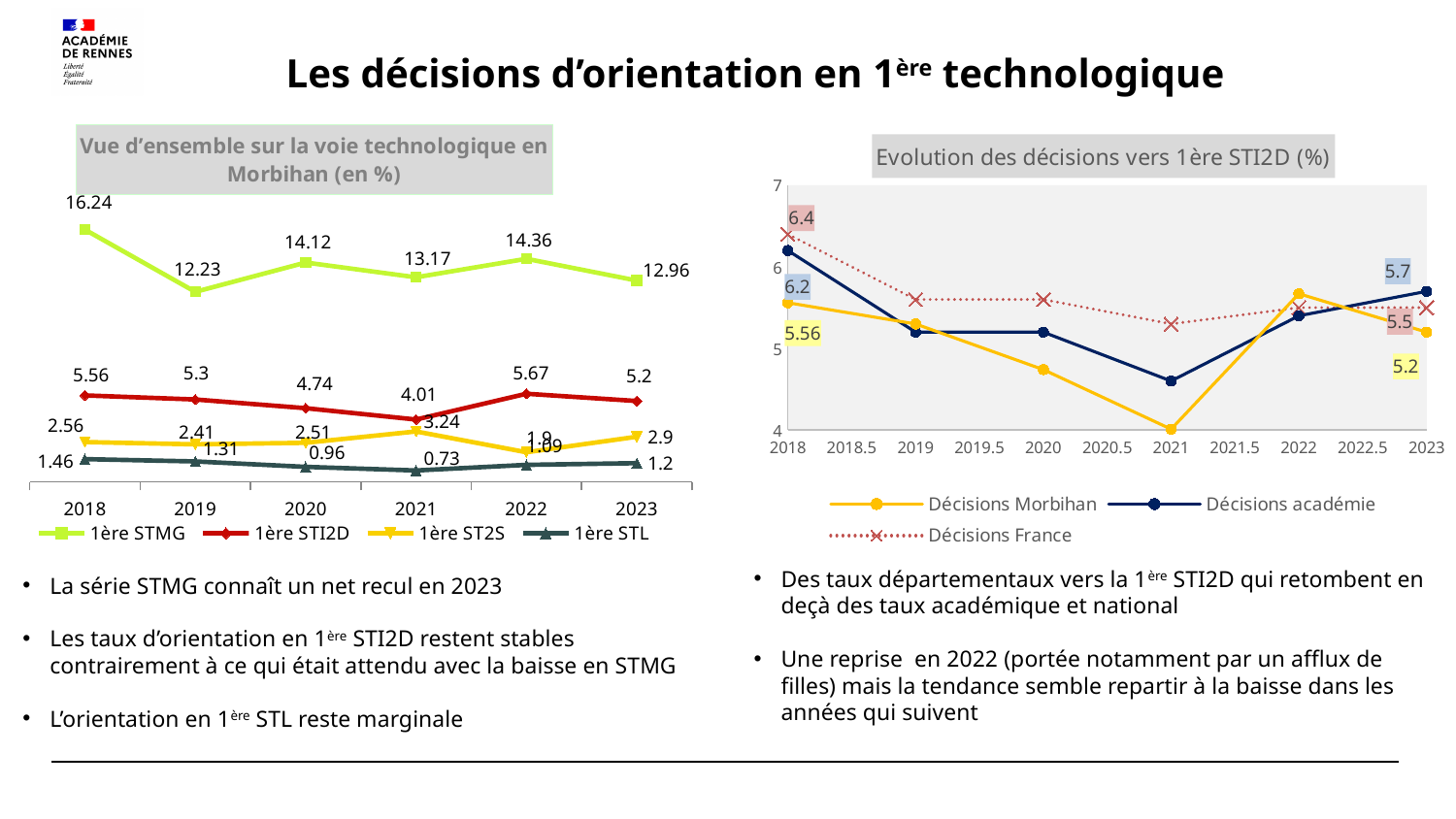
In the 'Vue d'ensemble sur la voie technologique en Morbihan' chart, what is the difference between the 1ère STMG values for 2022 and 2023? 1.4 In the 'Evolution des décisions vers 1ère STI2D (%)' chart, which is larger in 2023: Décisions académie or Décisions Morbihan? Décisions académie What kind of chart is the 'Vue d'ensemble sur la voie technologique en Morbihan (en %)' chart? Line chart In the 'Vue d'ensemble sur la voie technologique en Morbihan' chart, what is the value for 1ère STMG in 2018? 16.24 In the 'Evolution des décisions vers 1ère STI2D (%)' chart, what is the value for Décisions France in 2018? 6.4 In the 'Vue d'ensemble sur la voie technologique en Morbihan' chart, in which year is the 1ère STMG value highest? 2018 How many series does the legend of the 'Vue d'ensemble sur la voie technologique en Morbihan' chart list? 4 In the 'Vue d'ensemble sur la voie technologique en Morbihan' chart, what is the value for 1ère STL in 2021? 0.73 How many series does the legend of the 'Evolution des décisions vers 1ère STI2D (%)' chart list? 3 How many years are shown on the x axis of the 'Vue d'ensemble sur la voie technologique en Morbihan' chart? 6 In the 'Evolution des décisions vers 1ère STI2D (%)' chart, is the value for Décisions Morbihan in 2021 greater or less than 5? less In the 'Vue d'ensemble sur la voie technologique en Morbihan' chart, what is the value for 1ère STI2D in 2021? 4.01